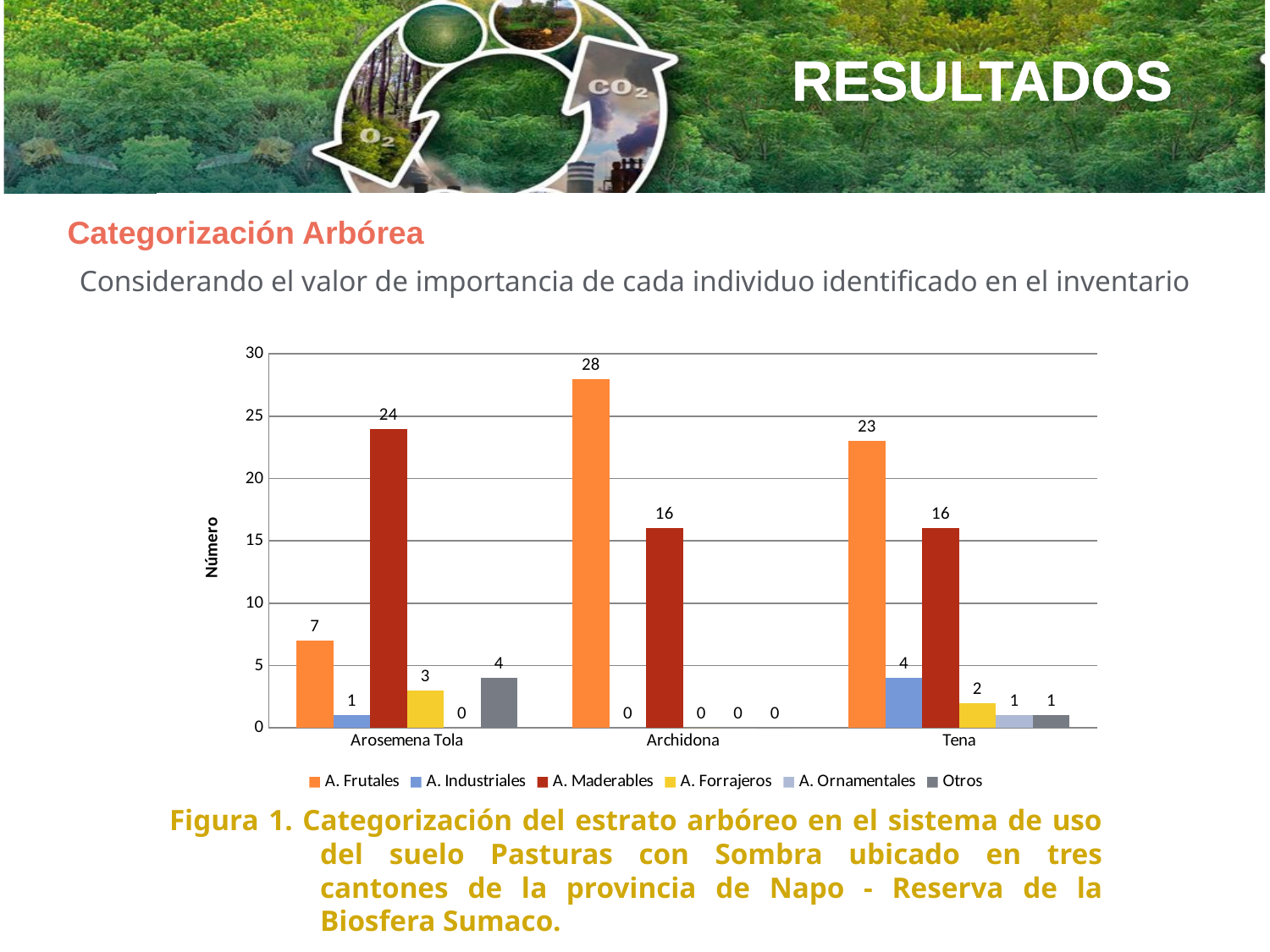
What type of chart is shown on the slide? Bar chart How many cantons (categories) are shown on the x axis? 3 What is the value for A. Maderables in Arosemena Tola? 24 What is the value for A. Frutales in Archidona? 28 Which canton has the lowest value for A. Maderables? Archidona and Tena (both 16) What is the difference between A. Frutales and A. Maderables in Tena? 7 What is the value for Otros in Arosemena Tola? 4 What is the label of the y axis? Número Which canton has the highest value for A. Frutales? Archidona Which is larger in Arosemena Tola: A. Frutales or A. Maderables? A. Maderables How many series does the legend list? 6 What is the value for A. Industriales in Tena? 4